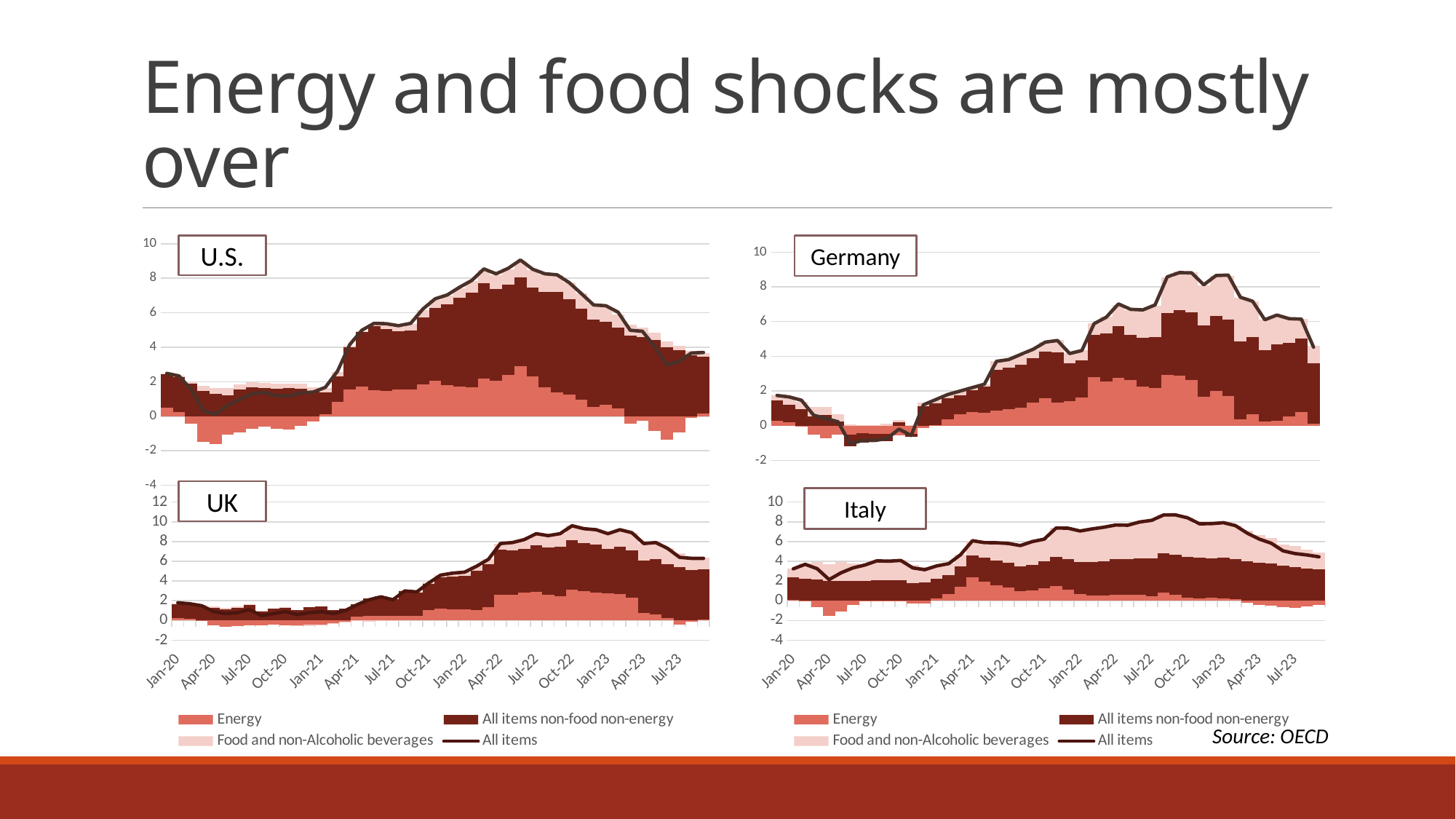
In the U.S. chart, does the All items line rise or fall between Jul-22 and Jul-23? fall What is the source cited for the charts on the slide? OECD In the Italy chart, is the All items value at Oct-22 greater or less than 8? greater What kind of chart is used for each country on the slide? Stacked bar chart with a line overlay Which series is drawn as a line rather than bars in the charts? All items In the U.S. chart, is the All items value higher at Jul-22 or at Jan-20? Jul-22 How many charts are shown on the slide? 4 In the U.S. chart, is the All items value at Jul-22 greater or less than 8? greater How many series does the legend list for each chart? 4 In the Germany chart, is the All items value at Jul-20 greater or less than 0? less In the Germany chart, does the All items line rise or fall between Jan-21 and Oct-22? rise